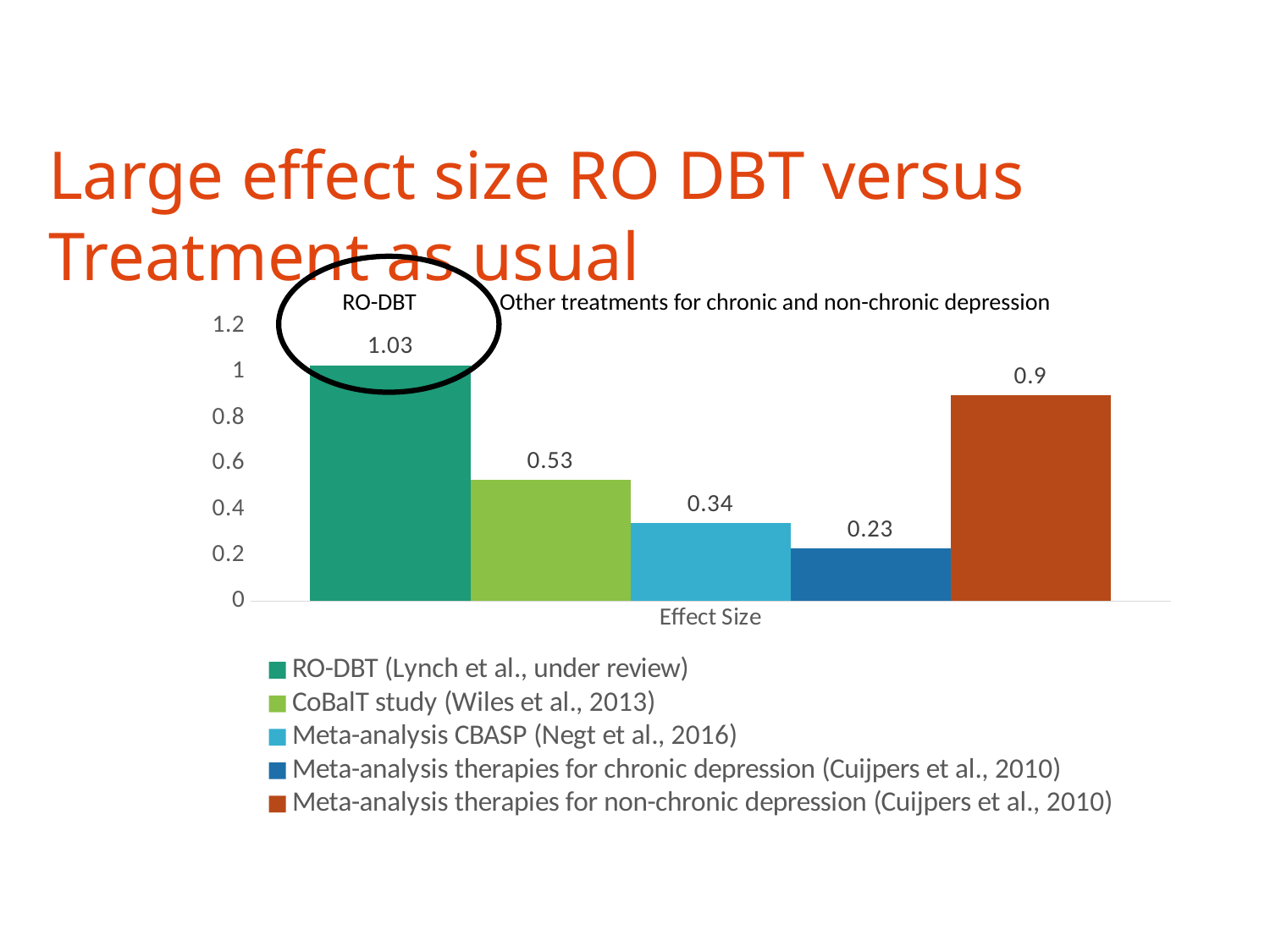
What is the effect size for the CoBalT study (Wiles et al., 2013)? 0.53 What is the effect size for RO-DBT (Lynch et al., under review)? 1.03 What is the effect size for Meta-analysis CBASP (Negt et al., 2016)? 0.34 Which series has the lowest effect size? Meta-analysis therapies for chronic depression (Cuijpers et al., 2010) What is the effect size for Meta-analysis therapies for non-chronic depression (Cuijpers et al., 2010)? 0.9 What is the label on the x axis of the chart? Effect Size What is the difference between the effect size for Meta-analysis therapies for non-chronic depression and Meta-analysis therapies for chronic depression? 0.67 Which series has the highest effect size? RO-DBT (Lynch et al., under review) What kind of chart is shown on the slide? Bar chart What is the difference between the effect size for RO-DBT and the effect size for the CoBalT study? 0.5 How many series does the legend list? 5 Which is larger: the effect size for Meta-analysis CBASP or the effect size for Meta-analysis therapies for chronic depression? Meta-analysis CBASP (Negt et al., 2016)